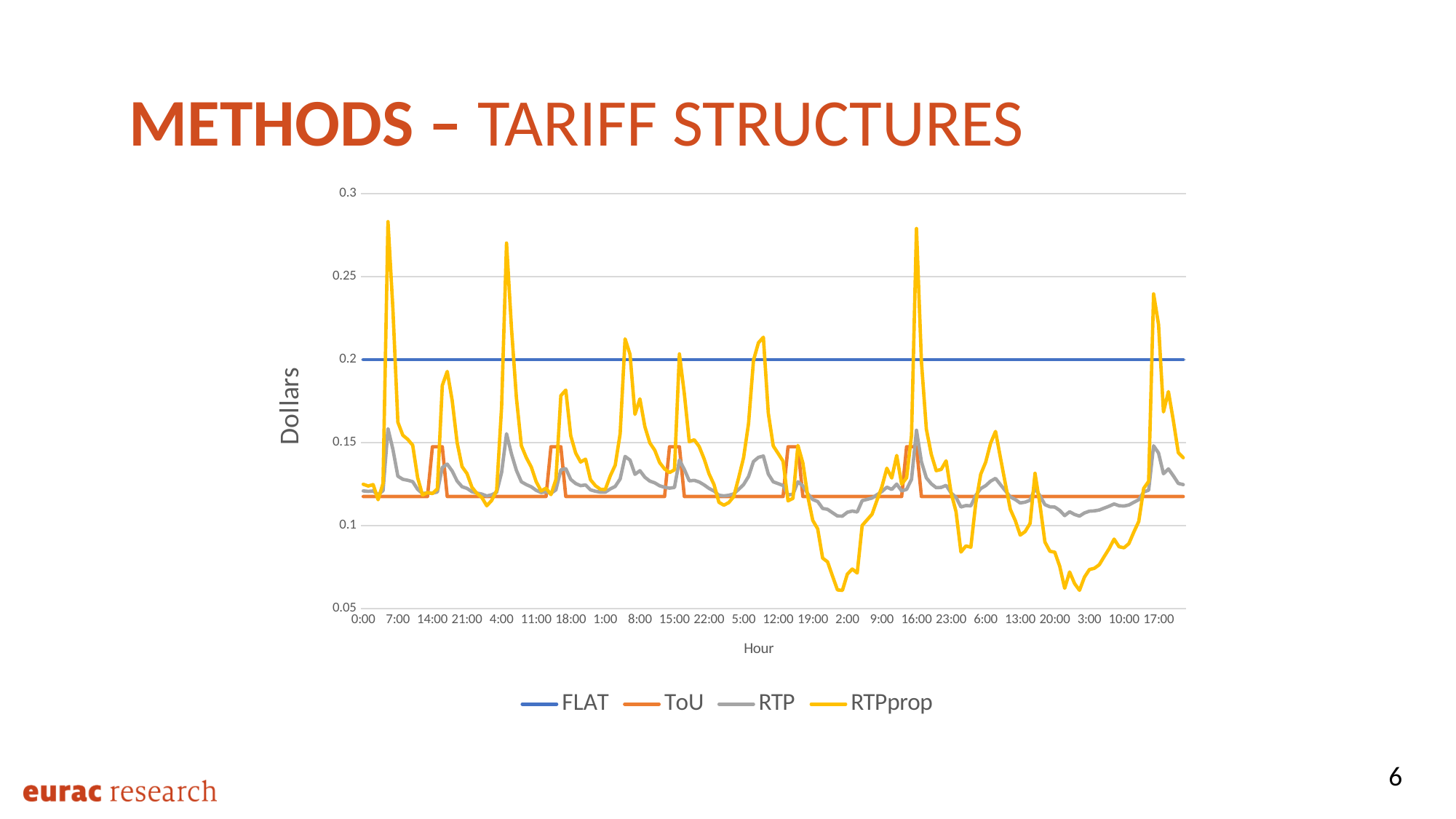
What is the label of the vertical axis? Dollars What is the value of the FLAT tariff in dollars? 0.2 Which series stays constant across all hours? FLAT What kind of chart is shown on the slide? line chart Is the off-peak value of ToU greater or less than 0.15? less Which is higher, the FLAT tariff or the ToU tariff? FLAT Is the highest value of RTP greater or less than 0.2? less How many series does the legend list? 4 Is the highest value of RTPprop greater or less than 0.25? greater Which series reaches the highest value on the chart? RTPprop